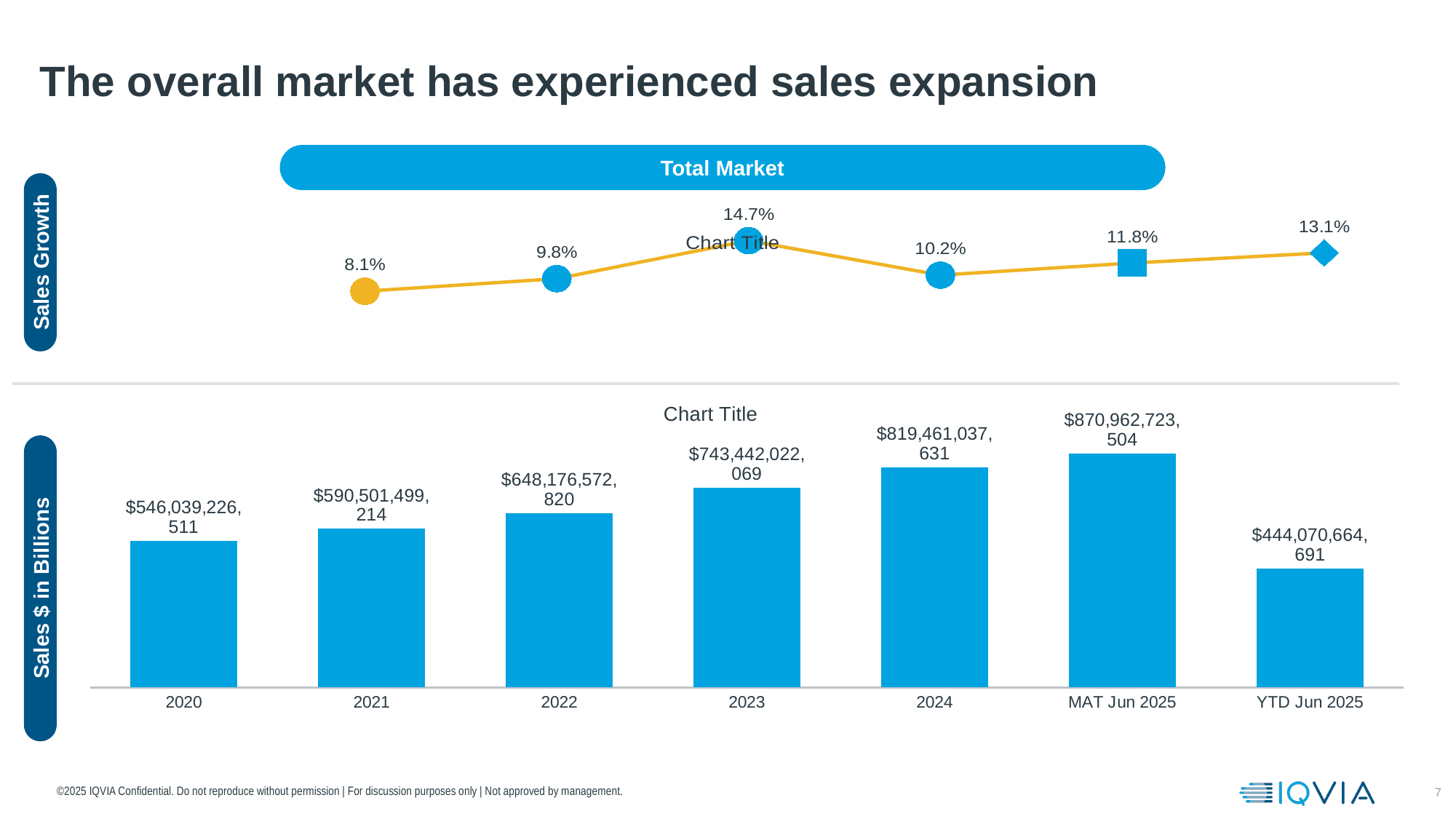
In the lower bar chart, what is the difference between the MAT Jun 2025 value and the 2024 value? $51,501,685,873 In the lower bar chart, what is the value for 2020? $546,039,226,511 In the lower bar chart, how many bars are there? 7 In the lower bar chart, which category has the highest value? MAT Jun 2025 What kind of chart is the upper chart (Sales Growth)? line chart In the upper Sales Growth line chart, how many data points are plotted? 6 What kind of chart is the lower chart (Sales $ in Billions)? bar chart In the lower bar chart, what is the value for YTD Jun 2025? $444,070,664,691 In the lower bar chart, is the value for 2022 larger or smaller than the value for 2023? smaller In the upper Sales Growth line chart, what is the highest value shown? 14.7% In the lower bar chart, what is the value for MAT Jun 2025? $870,962,723,504 In the lower bar chart, which category has the lowest value? YTD Jun 2025